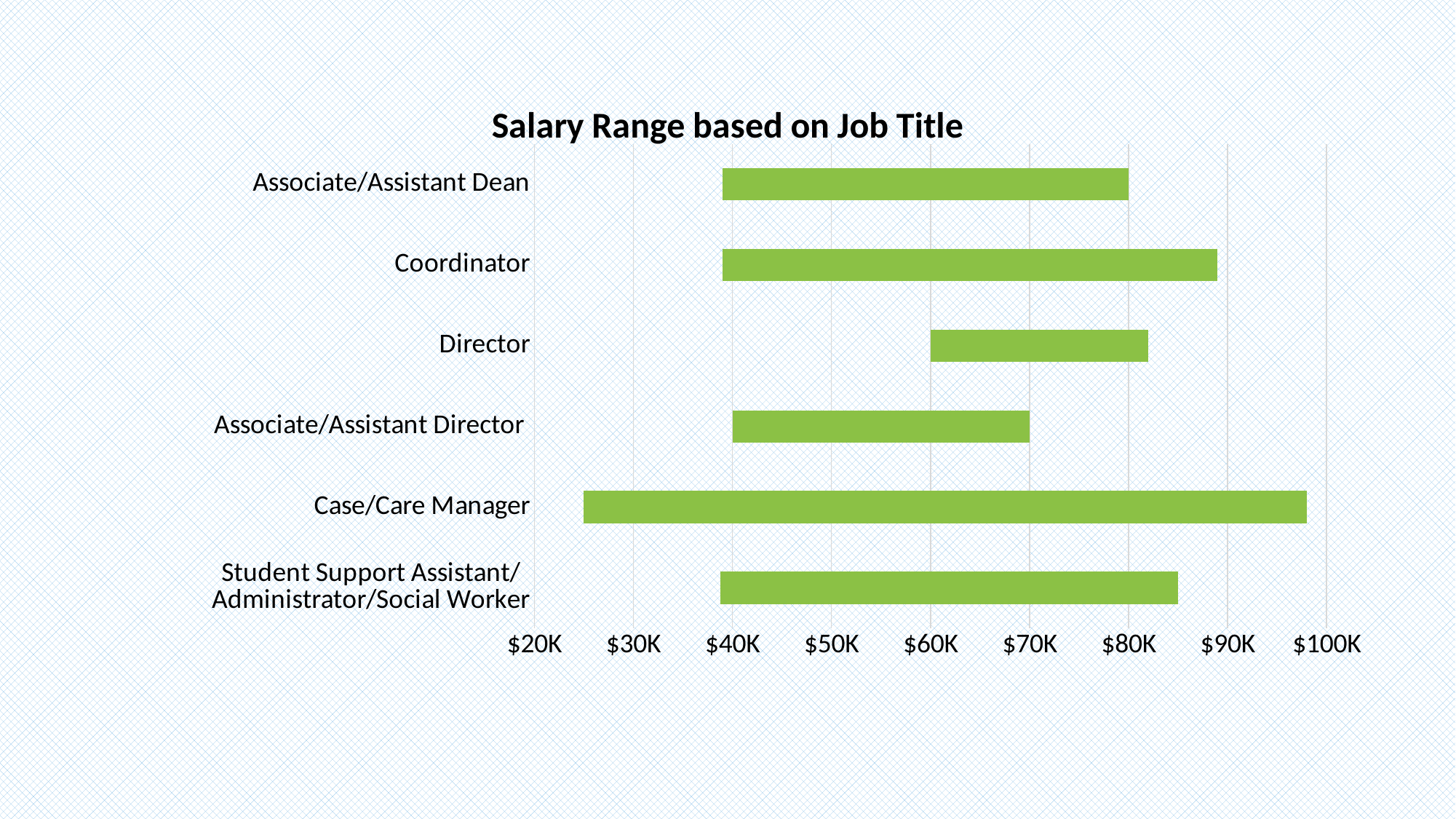
Which has a higher lower end of its salary range, Director or Associate/Assistant Director? Director Which has a higher upper end of its salary range, Coordinator or Associate/Assistant Dean? Coordinator Which job title has the highest upper end of its salary range? Case/Care Manager Is the upper end of the salary range for Associate/Assistant Director greater or less than $80K? less Which job title has the narrowest salary range bar? Director Which job title has the lowest lower end of its salary range? Case/Care Manager Is the lower end of the salary range for Case/Care Manager greater or less than $30K? less What is the title of the chart? Salary Range based on Job Title Is the lower end of the salary range for Director greater or less than $50K? greater How many job titles are shown in the chart? 6 Which job title has the widest salary range bar? Case/Care Manager What kind of chart is shown on the slide? bar chart